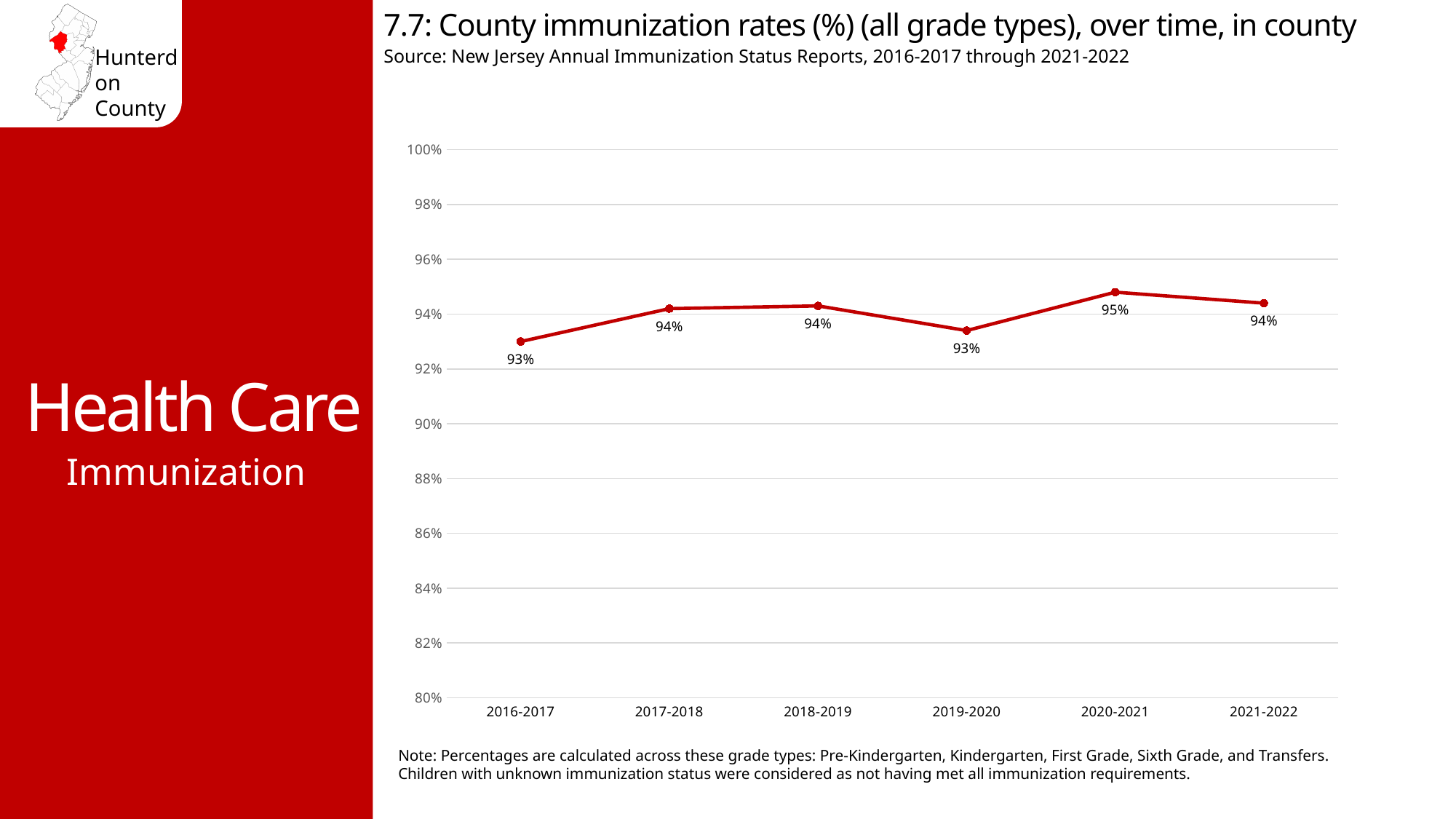
What is the source cited for the chart? New Jersey Annual Immunization Status Reports, 2016-2017 through 2021-2022 What is the county immunization rate for 2016-2017? 93% What is the difference between the immunization rate in 2020-2021 and in 2016-2017? 2% What is the county immunization rate for 2021-2022? 94% How many school years are plotted on the chart? 6 Is the immunization rate higher in 2020-2021 or in 2016-2017? 2020-2021 What kind of chart is shown on the slide? line chart Does the immunization rate rise or fall from 2016-2017 to 2017-2018? rise What is the county immunization rate for 2020-2021? 95% Is the immunization rate for 2016-2017 greater or less than 92%? greater Which school year has the highest immunization rate? 2020-2021 What is the county immunization rate for 2019-2020? 93%